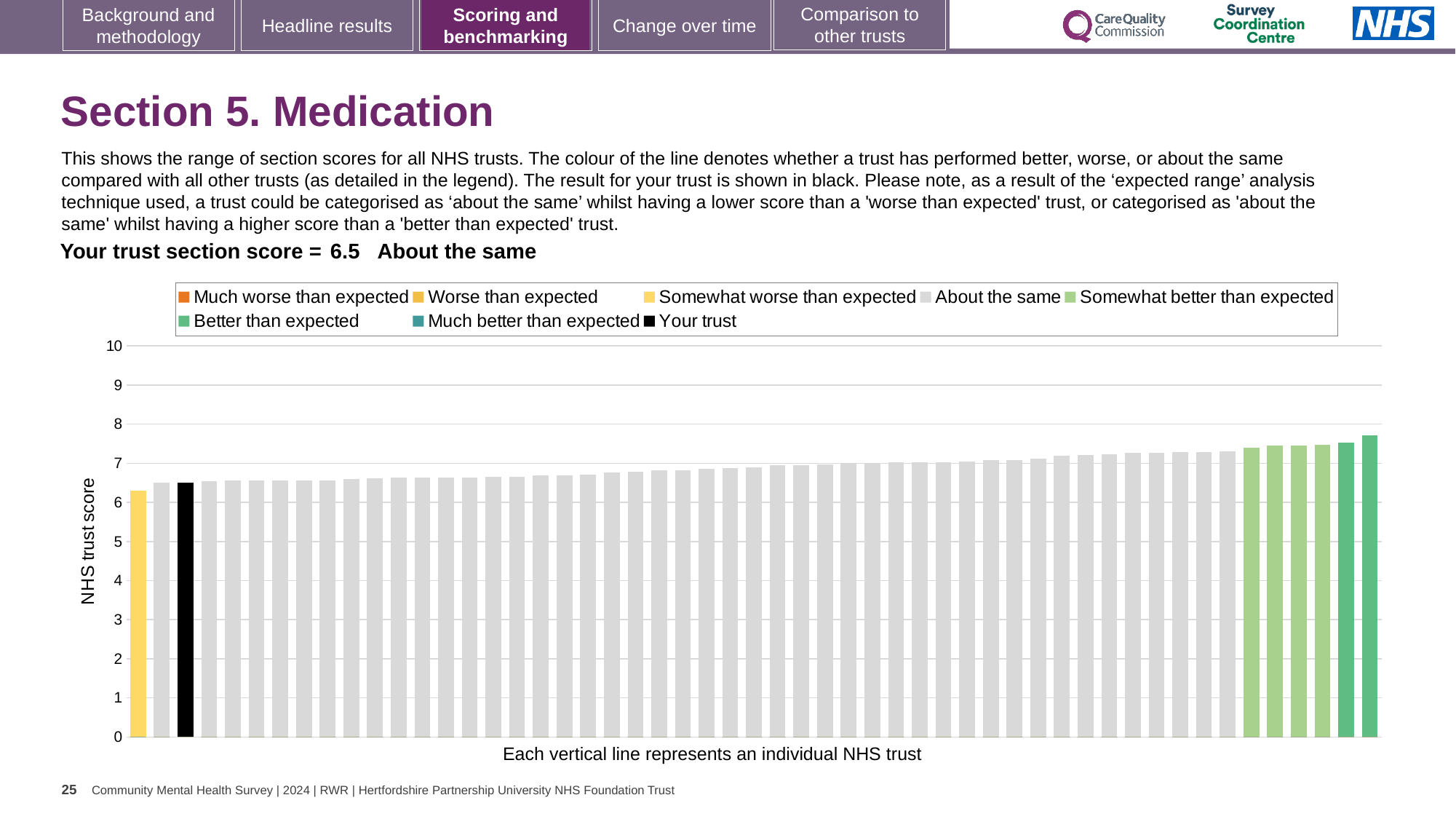
What is the label on the vertical axis of the chart? NHS trust score What is the section score for your trust shown on the slide? 6.5 What kind of chart is shown on the slide? bar chart Is the value of the tallest bar greater or less than 8? less Which legend category does the tallest bar on the right belong to? Better than expected What colour is the bar representing your trust? black Which performance category is your trust placed in for Section 5 Medication? About the same Is the value for your trust (the black bar) greater or less than 6? greater How many entries does the chart legend list? 8 Is the value of the tallest bar greater or less than 7? greater Do the bar values rise or fall from left to right along the x axis? rise